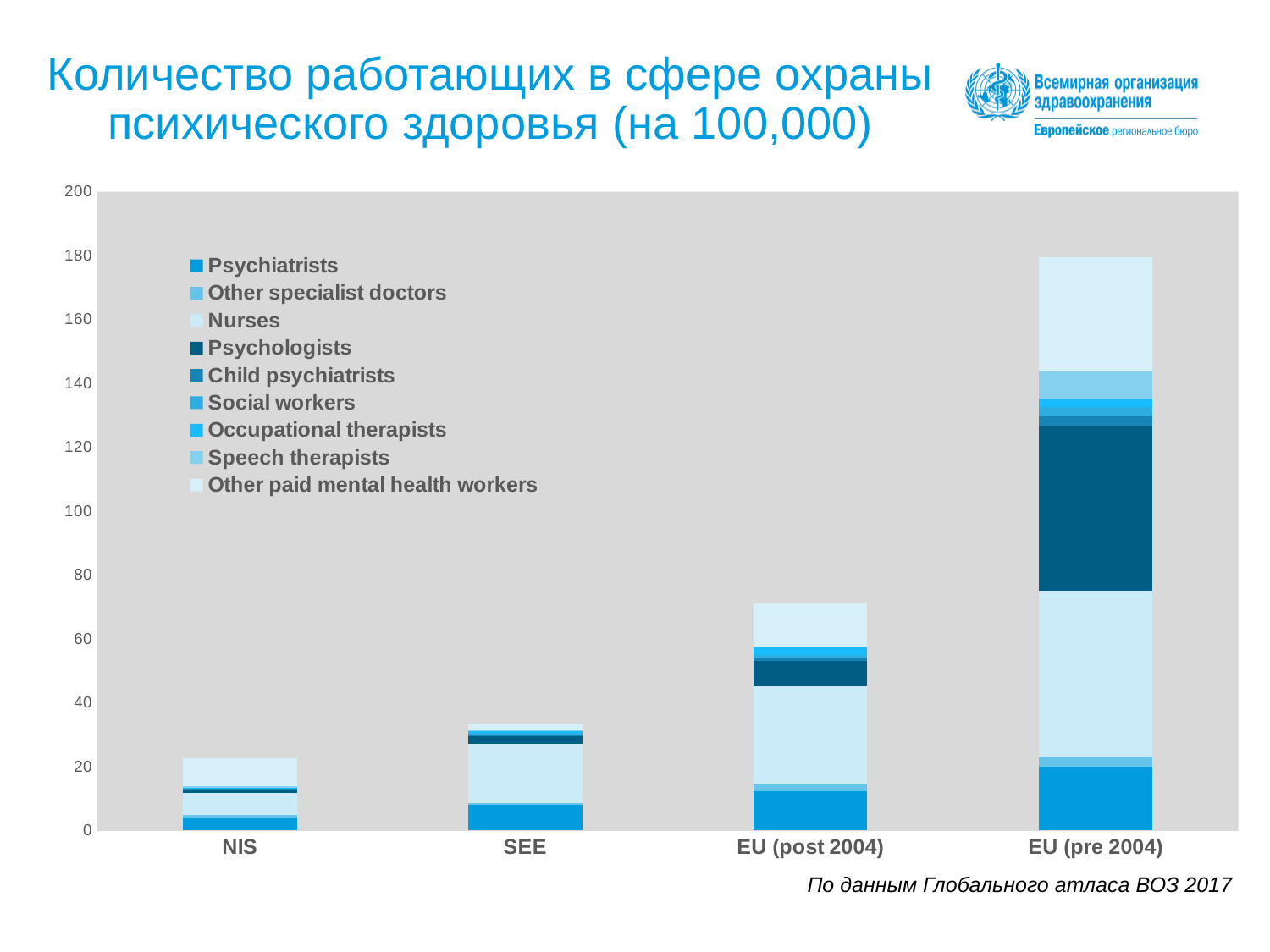
Which has a taller stacked bar, SEE or EU (post 2004)? EU (post 2004) Do the total stacked values rise or fall moving from NIS to EU (pre 2004) along the x axis? Rise Is the total stacked value for SEE greater or less than 20? greater How many categories are shown on the x axis of the chart? 4 Is the total stacked value for EU (pre 2004) greater or less than 160? greater Is the total stacked value for EU (post 2004) greater or less than 60? greater How many series does the chart's legend list? 9 Which category has the shortest stacked bar? NIS Which series is listed first in the chart's legend? Psychiatrists Which category has the tallest stacked bar? EU (pre 2004) What kind of chart is shown on the slide? Stacked bar chart